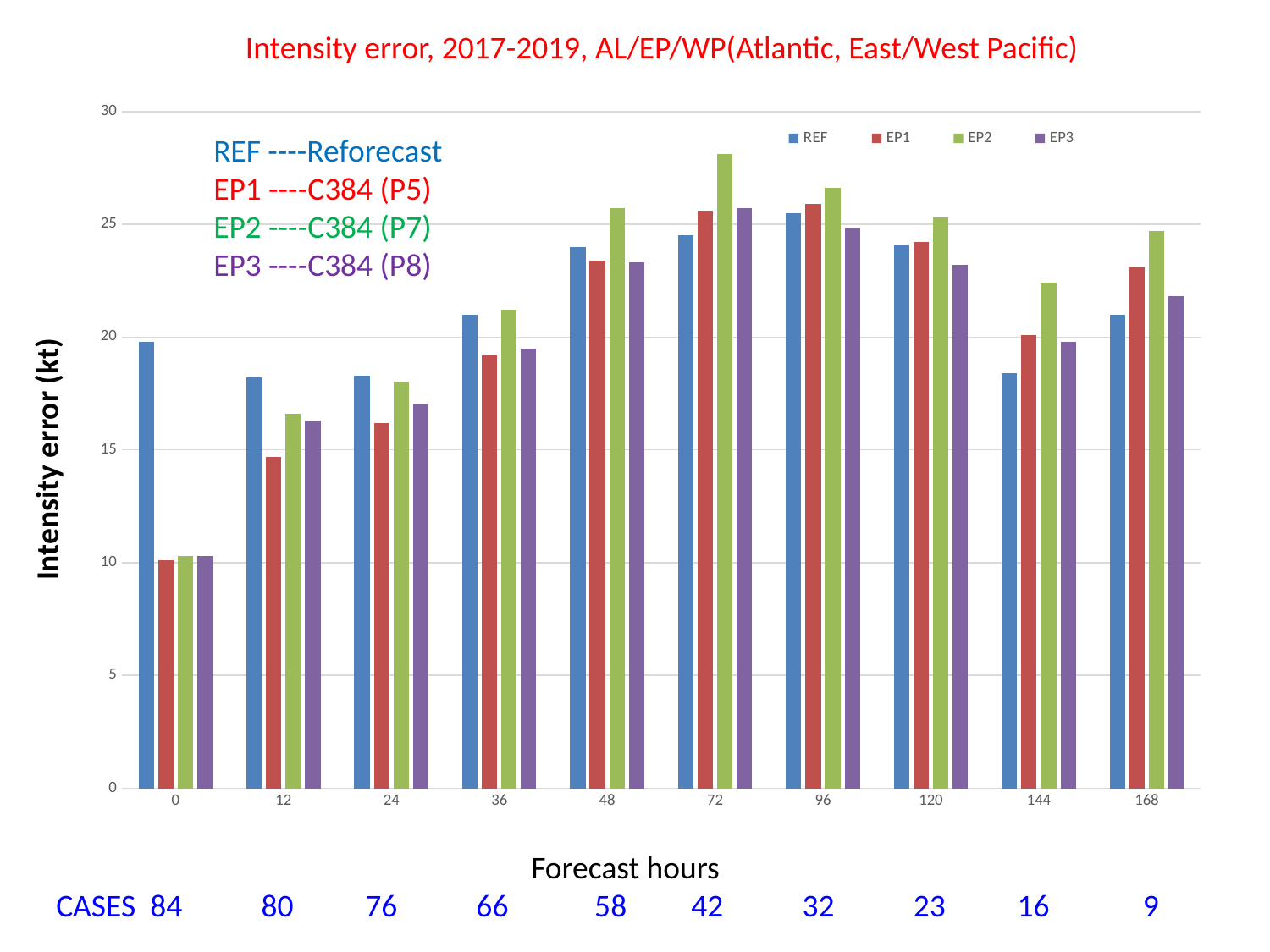
How many series does the legend list? 4 At forecast hour 144, which is larger, EP2 or REF? EP2 At forecast hour 12, which is larger, REF or EP1? REF What kind of chart is shown on the slide? bar chart How many forecast-hour categories are shown on the x axis? 10 What is the label on the y axis? Intensity error (kt) Is the EP1 value at forecast hour 0 greater or less than 15? less What is the title of the chart? Intensity error, 2017-2019, AL/EP/WP(Atlantic, East/West Pacific) At which forecast hour is the EP2 intensity error highest? 72 Which series has the lowest intensity error at forecast hour 12? EP1 Is the REF value at forecast hour 0 greater or less than 15? greater Is the EP2 value at forecast hour 72 greater or less than 25? greater